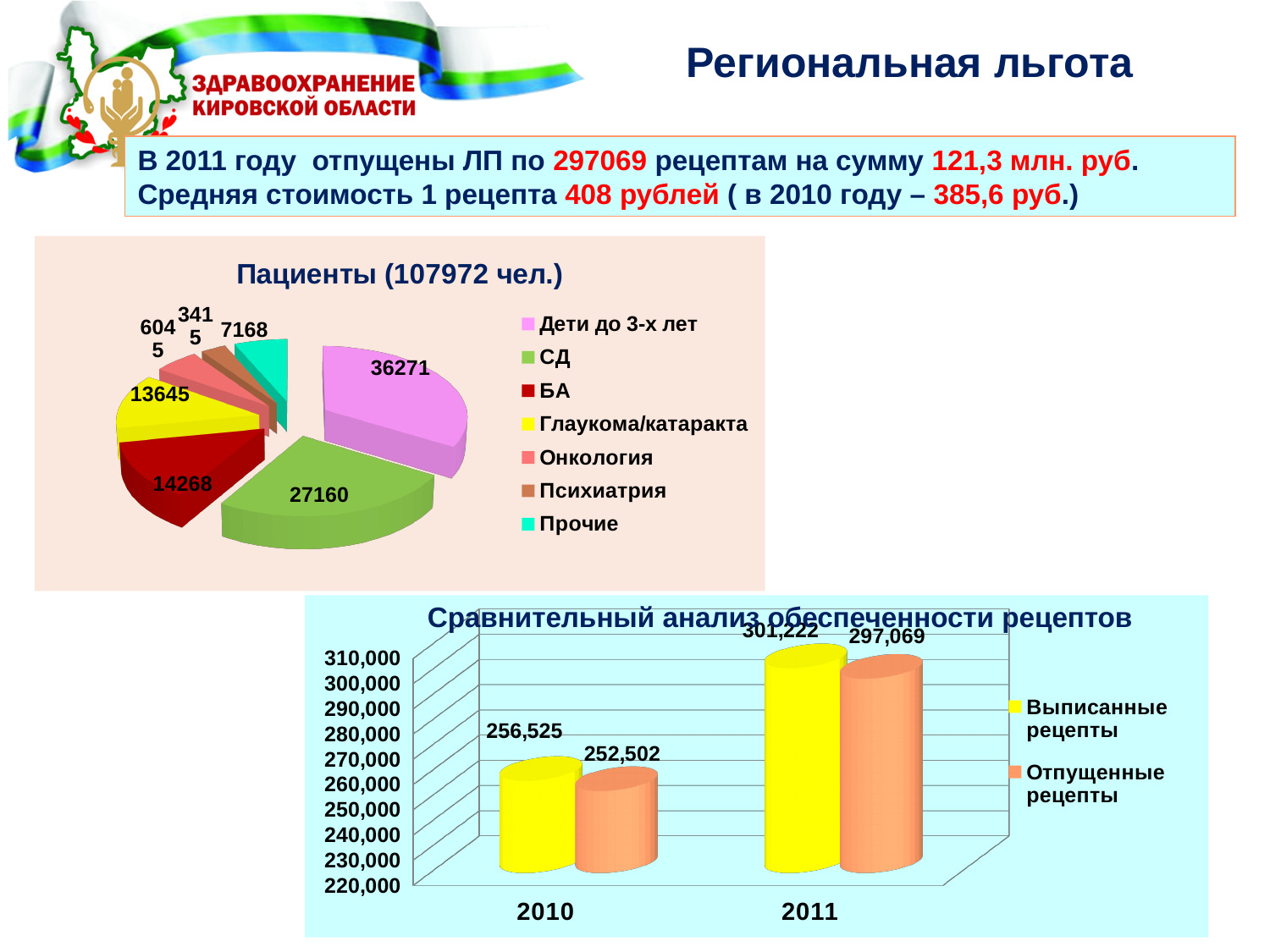
In the chart 'Сравнительный анализ обеспеченности рецептов', how many series does the legend list? 2 In the pie chart 'Пациенты (107972 чел.)', what is the difference between the values for 'Дети до 3-х лет' and 'СД'? 9111 In the pie chart 'Пациенты (107972 чел.)', which category has the largest value? Дети до 3-х лет What kind of chart is 'Сравнительный анализ обеспеченности рецептов'? bar chart In the chart 'Сравнительный анализ обеспеченности рецептов', what is the value of 'Выписанные рецепты' for 2011? 301,222 In the chart 'Сравнительный анализ обеспеченности рецептов', what is the difference between 'Выписанные рецепты' and 'Отпущенные рецепты' in 2010? 4,023 In the chart 'Сравнительный анализ обеспеченности рецептов', do the values for 'Отпущенные рецепты' rise or fall from 2010 to 2011? rise In the pie chart 'Пациенты (107972 чел.)', how many categories does the legend list? 7 In the pie chart 'Пациенты (107972 чел.)', which is larger: 'БА' or 'Глаукома/катаракта'? БА In the pie chart 'Пациенты (107972 чел.)', what is the value for 'СД'? 27160 In the pie chart 'Пациенты (107972 чел.)', what is the value for 'Дети до 3-х лет'? 36271 In the chart 'Сравнительный анализ обеспеченности рецептов', what is the value of 'Отпущенные рецепты' for 2010? 252,502